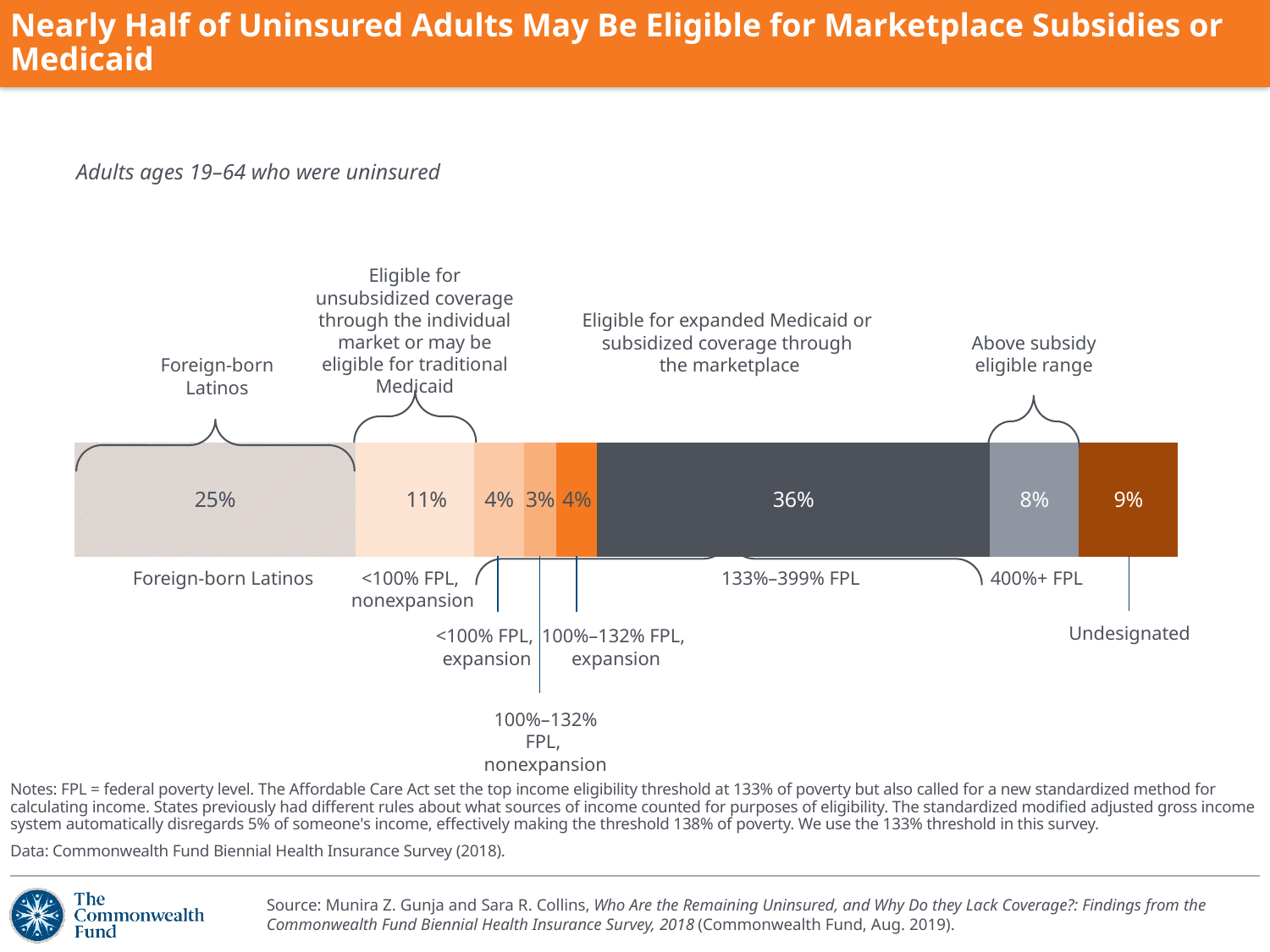
What percentage of uninsured adults are in the <100% FPL, nonexpansion segment? 11% What kind of chart is shown on the slide? Stacked bar chart What is the difference between the 133%–399% FPL segment and the foreign-born Latinos segment? 11 percentage points Which segment of the bar is the smallest? 100%–132% FPL, nonexpansion Which is larger, the 400%+ FPL segment or the undesignated segment? Undesignated What percentage of uninsured adults are foreign-born Latinos? 25% Which segment of the bar is the largest? 133%–399% FPL What percentage of uninsured adults are in the 133%–399% FPL segment? 36% How many segments make up the stacked bar? 8 What percentage of uninsured adults are undesignated? 9% What is the combined share of the <100% FPL, expansion and 100%–132% FPL, expansion segments? 8% What percentage of uninsured adults are in the 400%+ FPL segment? 8%